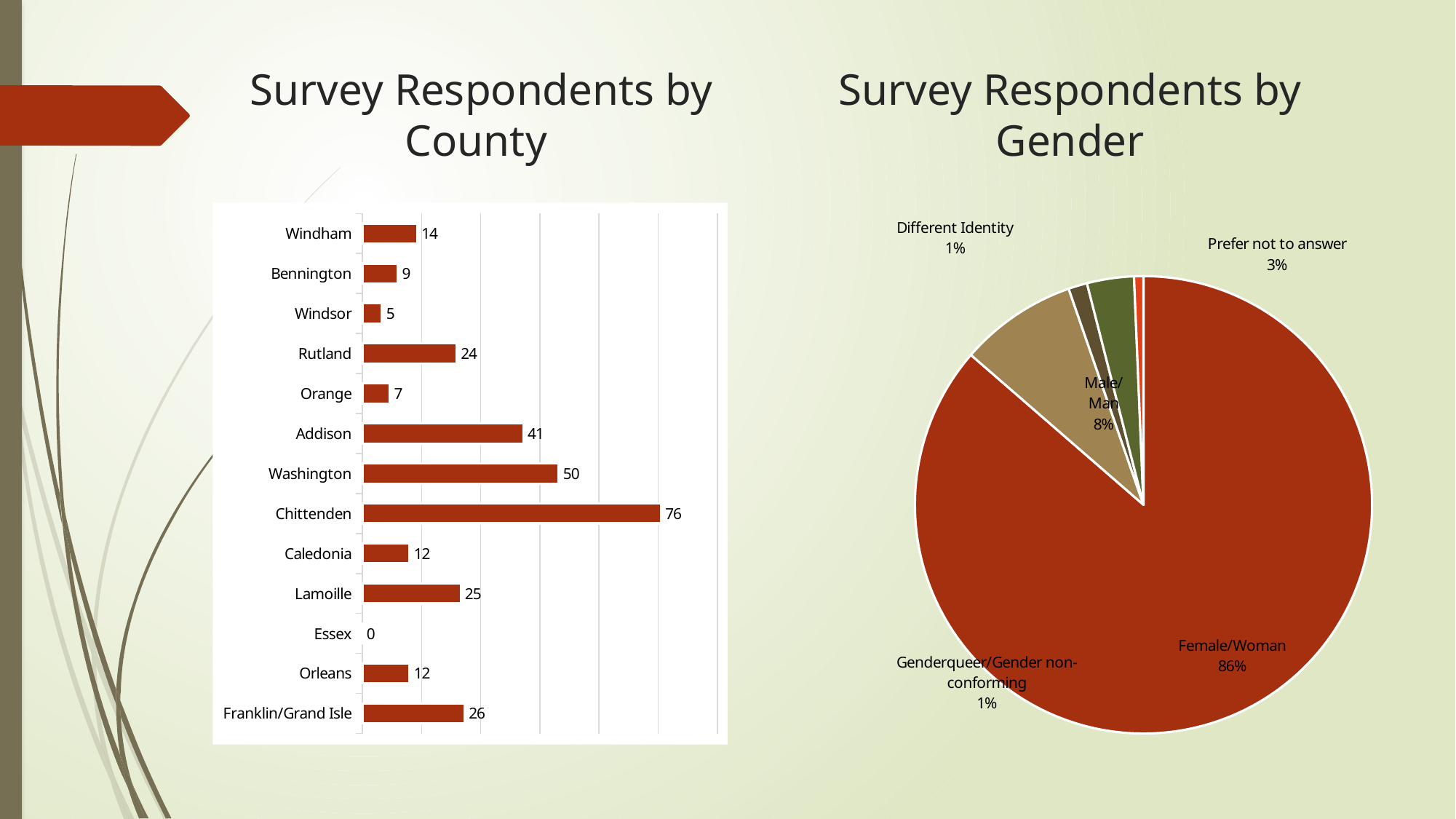
In the Survey Respondents by Gender chart, what share of respondents are Male/Man? 8% How many counties are shown in the Survey Respondents by County chart? 13 In the Survey Respondents by County chart, what is the difference between Washington and Addison? 9 In the Survey Respondents by Gender chart, which is larger, Prefer not to answer or Different Identity? Prefer not to answer In the Survey Respondents by County chart, which county has the lowest number of respondents? Essex What kind of chart is the Survey Respondents by Gender chart? Pie chart In the Survey Respondents by County chart, what is the value for Rutland? 24 In the Survey Respondents by Gender chart, what share of respondents are Female/Woman? 86% What kind of chart is the Survey Respondents by County chart? Bar chart In the Survey Respondents by County chart, which county has the highest number of respondents? Chittenden In the Survey Respondents by County chart, which is larger, Lamoille or Franklin/Grand Isle? Franklin/Grand Isle In the Survey Respondents by County chart, what is the value for Chittenden? 76